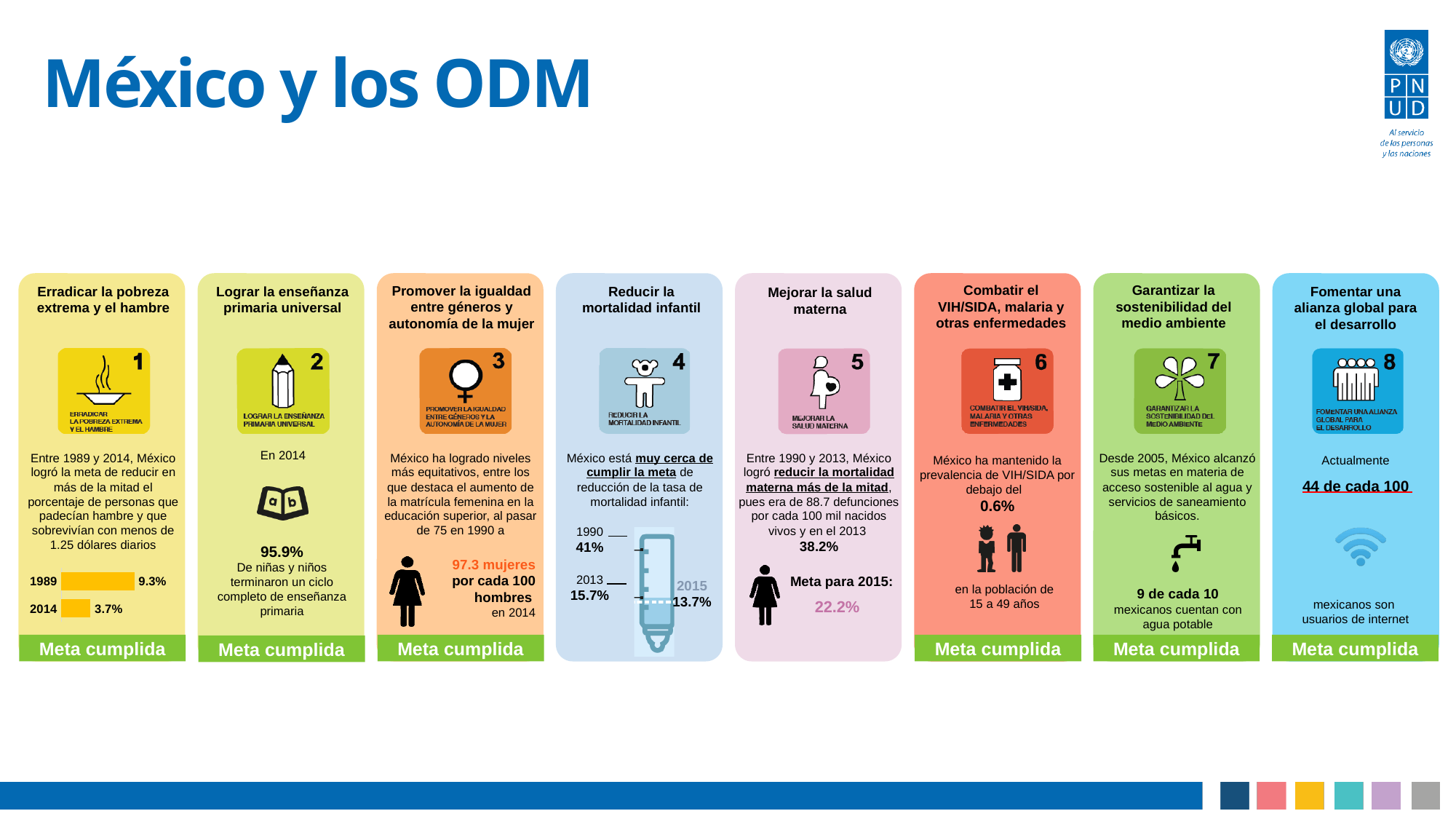
In the bar chart in the 'Erradicar la pobreza extrema y el hambre' panel, what is the difference between the 1989 and 2014 values? 5.6% In the bar chart in the 'Erradicar la pobreza extrema y el hambre' panel, does the value rise or fall from 1989 to 2014? Fall In the thermometer chart in the 'Reducir la mortalidad infantil' panel, what is the difference between the 1990 and 2013 values? 25.3% In the bar chart in the 'Erradicar la pobreza extrema y el hambre' panel, what is the value for 1989? 9.3% In the thermometer chart in the 'Reducir la mortalidad infantil' panel, what is the value for 1990? 41% In the thermometer chart in the 'Reducir la mortalidad infantil' panel, which year has the highest value? 1990 How many bars are shown in the bar chart in the 'Erradicar la pobreza extrema y el hambre' panel? 2 What kind of chart is shown in the 'Erradicar la pobreza extrema y el hambre' panel? Bar chart In the bar chart in the 'Erradicar la pobreza extrema y el hambre' panel, what is the value for 2014? 3.7% In the thermometer chart in the 'Reducir la mortalidad infantil' panel, what is the value for 2013? 15.7% In the bar chart in the 'Erradicar la pobreza extrema y el hambre' panel, which year has the larger value, 1989 or 2014? 1989 In the thermometer chart in the 'Reducir la mortalidad infantil' panel, what is the 2015 target value? 13.7%